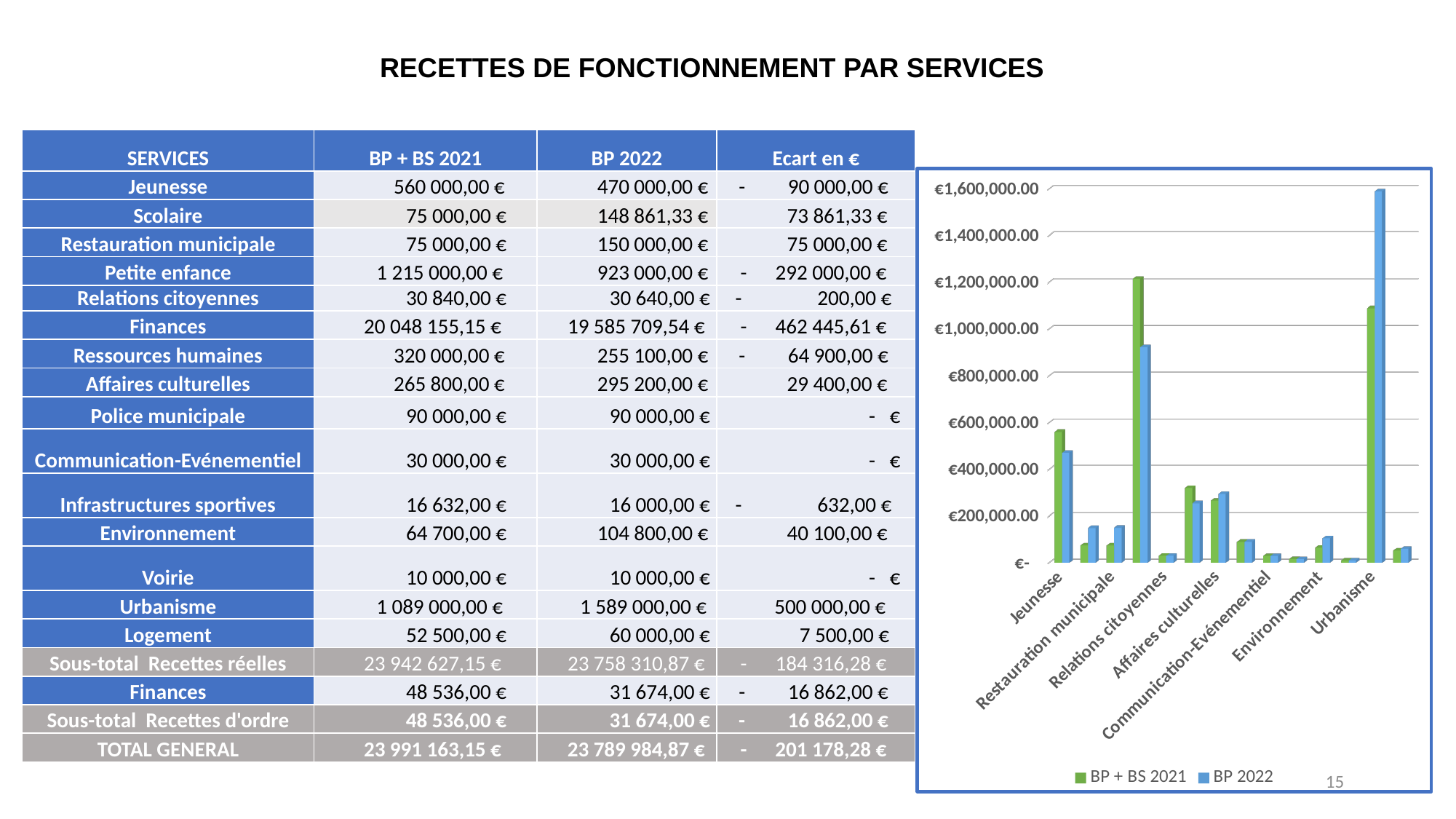
In the chart, is the BP 2022 value for Urbanisme greater or less than €1,400,000.00? greater In the chart, is the BP + BS 2021 value for Relations citoyennes greater or less than €200,000.00? less How many series does the chart legend list? 2 In the chart, is the BP 2022 value for Affaires culturelles greater or less than €200,000.00? greater What colour are the BP 2022 bars in the chart? blue Which category has the tallest BP 2022 bar in the chart? Urbanisme For Jeunesse, which series has the taller bar in the chart: BP + BS 2021 or BP 2022? BP + BS 2021 Which category has the taller BP 2022 bar in the chart: Jeunesse or Urbanisme? Urbanisme What kind of chart is shown on the right of the slide? bar chart For Urbanisme, which series has the taller bar in the chart: BP + BS 2021 or BP 2022? BP 2022